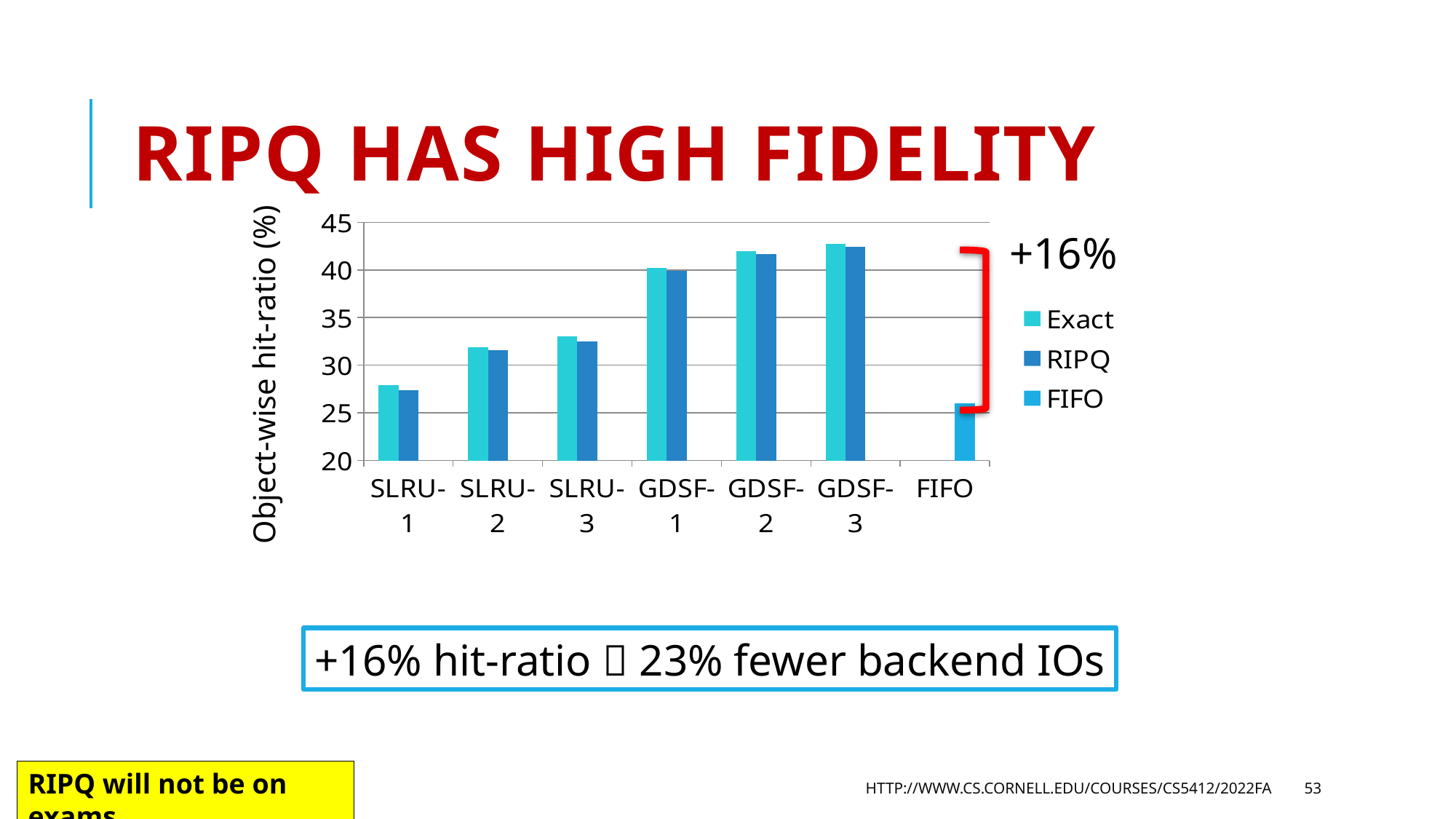
Is the Exact value for GDSF-2 greater or less than 40? greater What kind of chart is shown on the slide? bar chart Is the Exact value for SLRU-1 greater or less than 30? less What is the label of the chart's y axis? Object-wise hit-ratio (%) How many series does the chart legend list? 3 Is the value for FIFO greater or less than 30? less Which category has the lowest Exact hit-ratio? SLRU-1 Do the Exact values rise or fall from SLRU-1 to GDSF-3 along the x axis? rise How many categories are shown along the x axis of the chart? 7 Which category has the highest Exact hit-ratio? GDSF-3 Which has a larger RIPQ hit-ratio, SLRU-3 or GDSF-1? GDSF-1